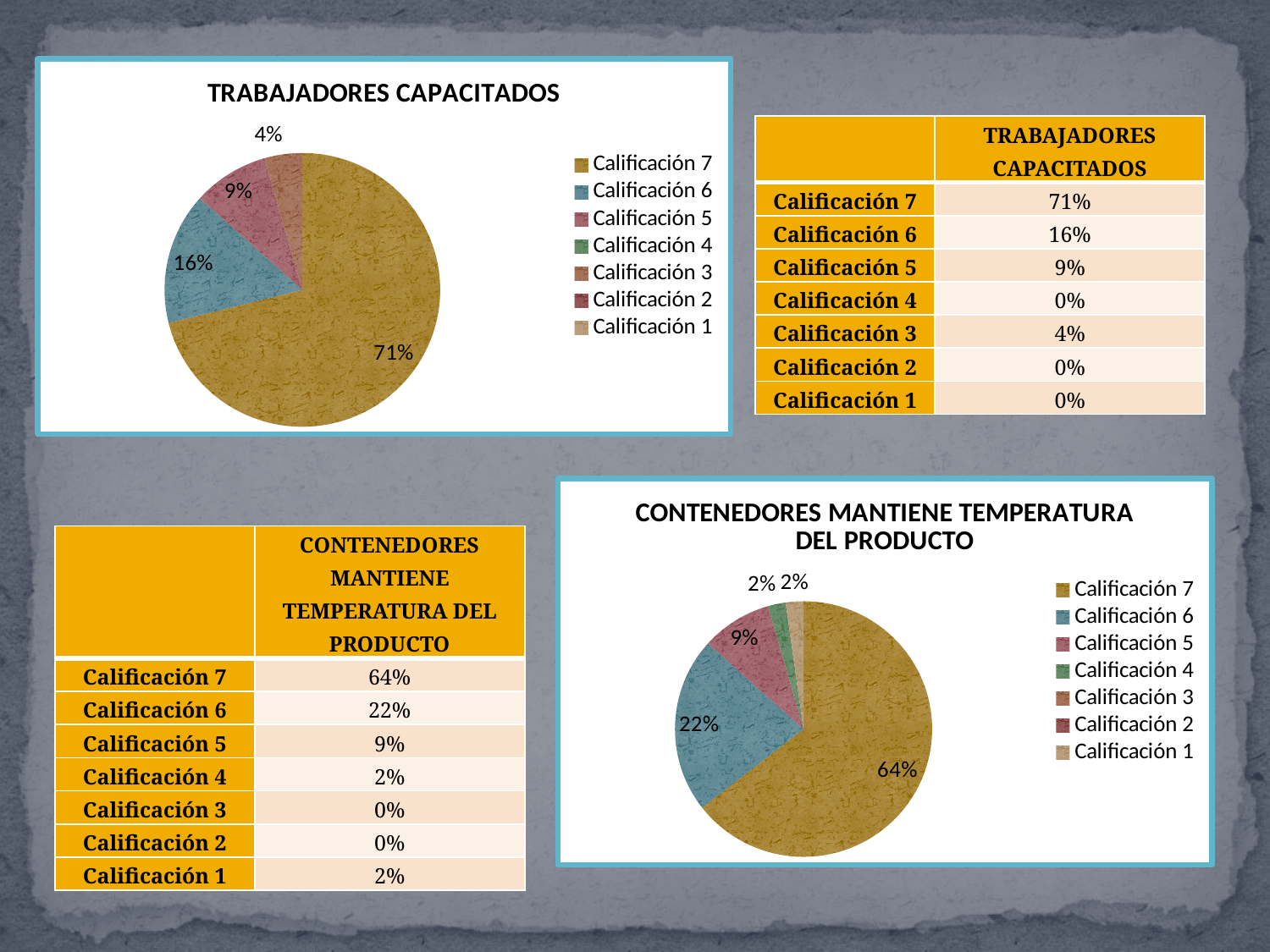
In the 'CONTENEDORES MANTIENE TEMPERATURA DEL PRODUCTO' chart, what share does Calificación 6 have? 22% In the 'TRABAJADORES CAPACITADOS' chart, what is the difference between the shares of Calificación 7 and Calificación 6? 55% In the 'TRABAJADORES CAPACITADOS' chart, which category has the largest slice? Calificación 7 In the 'TRABAJADORES CAPACITADOS' chart, what share does Calificación 7 have? 71% In the 'TRABAJADORES CAPACITADOS' chart, what share does Calificación 6 have? 16% In the 'CONTENEDORES MANTIENE TEMPERATURA DEL PRODUCTO' chart, what share does Calificación 7 have? 64% How many entries does the legend of the 'TRABAJADORES CAPACITADOS' chart list? 7 Which chart has the larger share for Calificación 7, 'TRABAJADORES CAPACITADOS' or 'CONTENEDORES MANTIENE TEMPERATURA DEL PRODUCTO'? TRABAJADORES CAPACITADOS In the 'CONTENEDORES MANTIENE TEMPERATURA DEL PRODUCTO' chart, which is larger, the share of Calificación 6 or Calificación 5? Calificación 6 What kind of chart is 'TRABAJADORES CAPACITADOS'? Pie chart What is the title of the pie chart in the lower right of the slide? CONTENEDORES MANTIENE TEMPERATURA DEL PRODUCTO In the 'CONTENEDORES MANTIENE TEMPERATURA DEL PRODUCTO' chart, what is the difference between the shares of Calificación 6 and Calificación 5? 13%